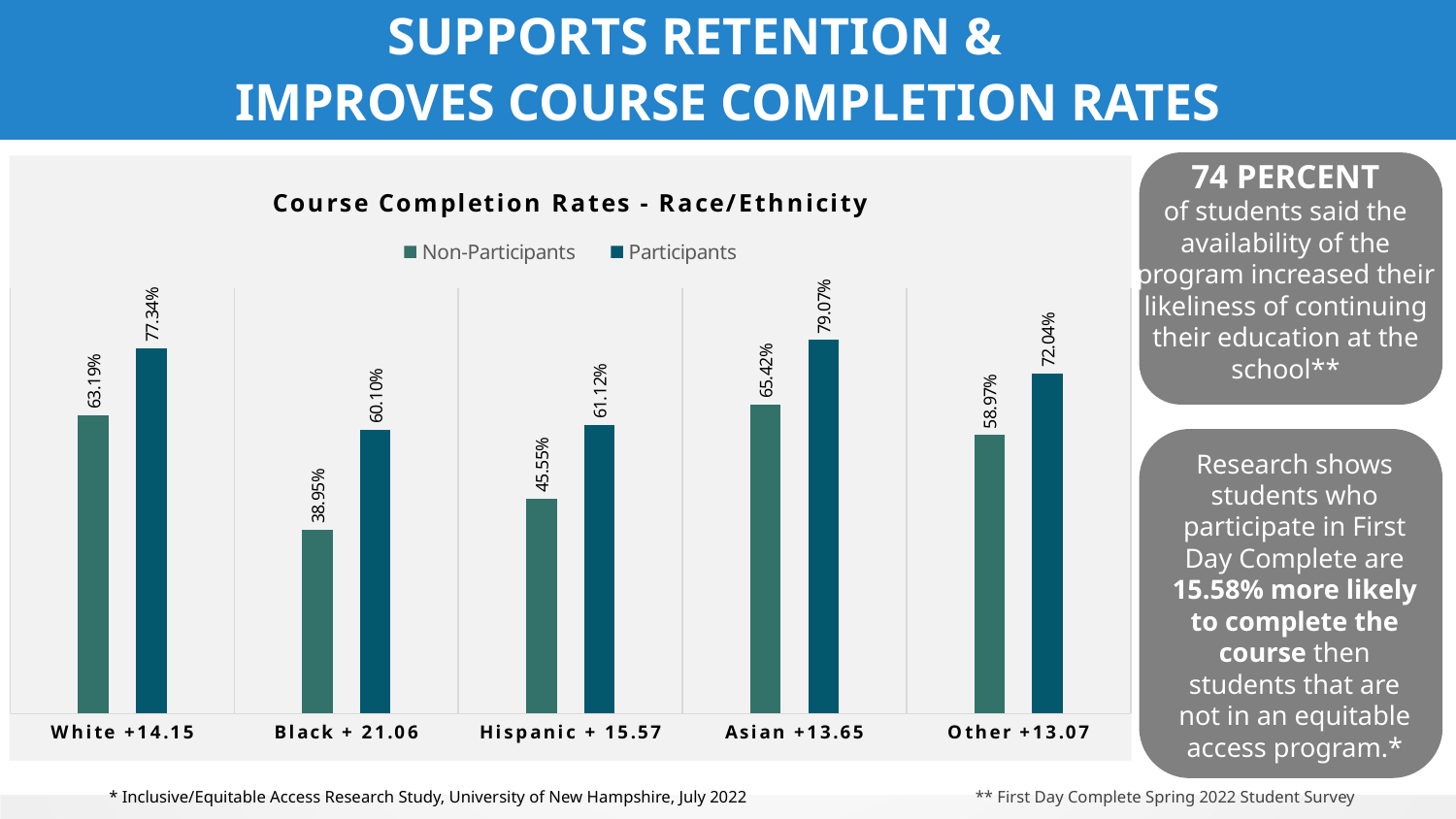
What is the Participants course completion rate for the Hispanic category? 61.12% What is the Participants course completion rate for the White category? 77.34% How many race/ethnicity categories are shown on the chart? 5 What kind of chart is shown on the slide? Bar chart What is the Non-Participants course completion rate for the Black category? 38.95% Which is larger: the Non-Participants rate for Asian or the Non-Participants rate for White? Asian How many series does the legend list? 2 What is the difference between the Participants and Non-Participants rates for the Hispanic category? 15.57 Which category has the highest Participants course completion rate? Asian Which category has the lowest Non-Participants course completion rate? Black What is the Non-Participants course completion rate for the Other category? 58.97% What is the title of the chart? Course Completion Rates - Race/Ethnicity